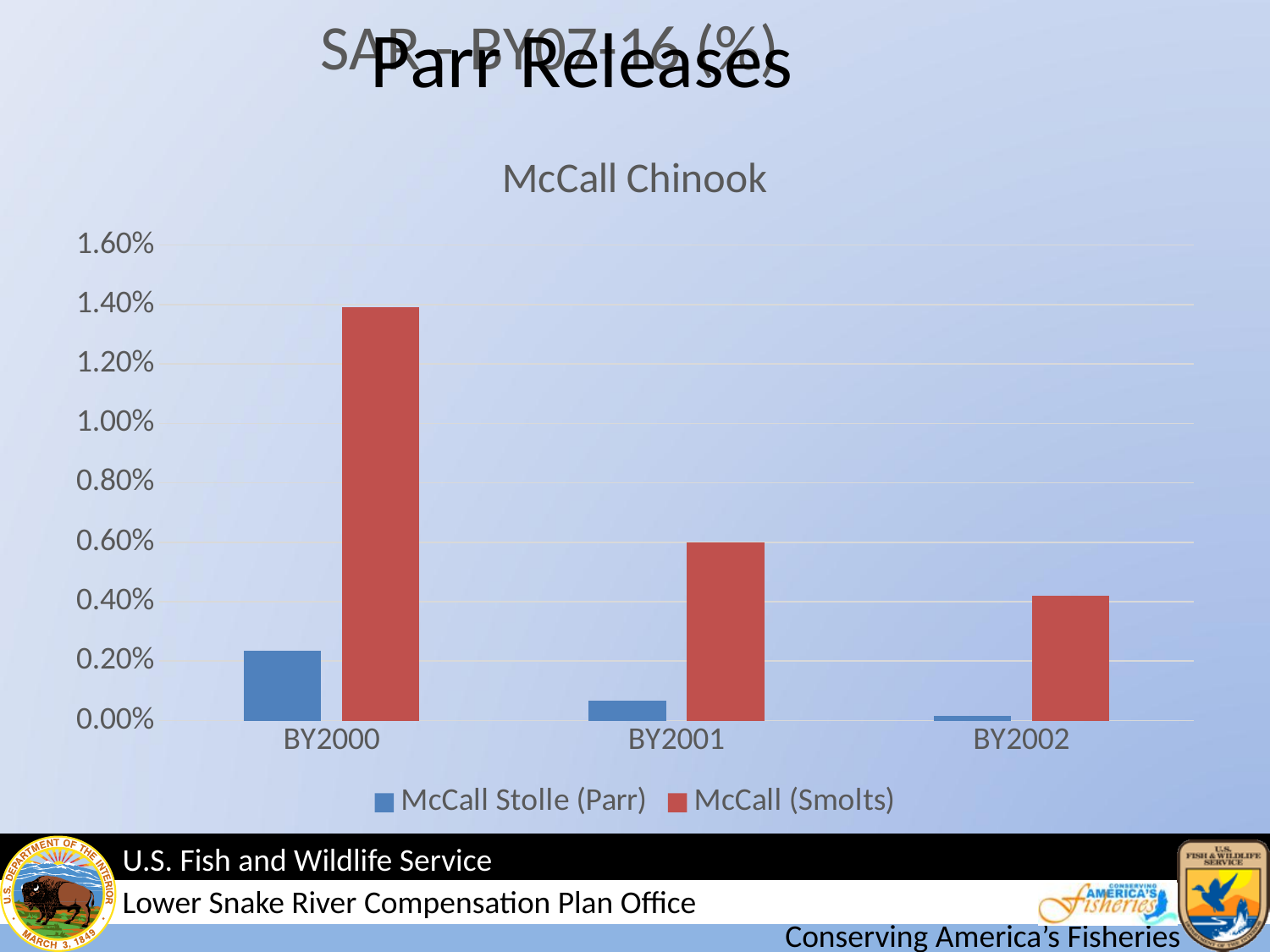
How many brood-year categories are shown on the x axis? 3 Do the McCall (Smolts) values rise or fall from BY2000 to BY2002? fall For which brood year is the McCall (Smolts) value lowest? BY2002 Which series is shown in red? McCall (Smolts) Is the McCall (Smolts) value for BY2000 greater or less than 1.20%? greater What is the title of the chart? McCall Chinook What type of chart is shown on the slide? bar chart Is the McCall (Smolts) value for BY2002 greater or less than 0.60%? less Is the McCall Stolle (Parr) value for BY2000 greater or less than 0.40%? less For which brood year is the McCall Stolle (Parr) value highest? BY2000 How many series does the legend list? 2 For which brood year is the McCall (Smolts) value highest? BY2000